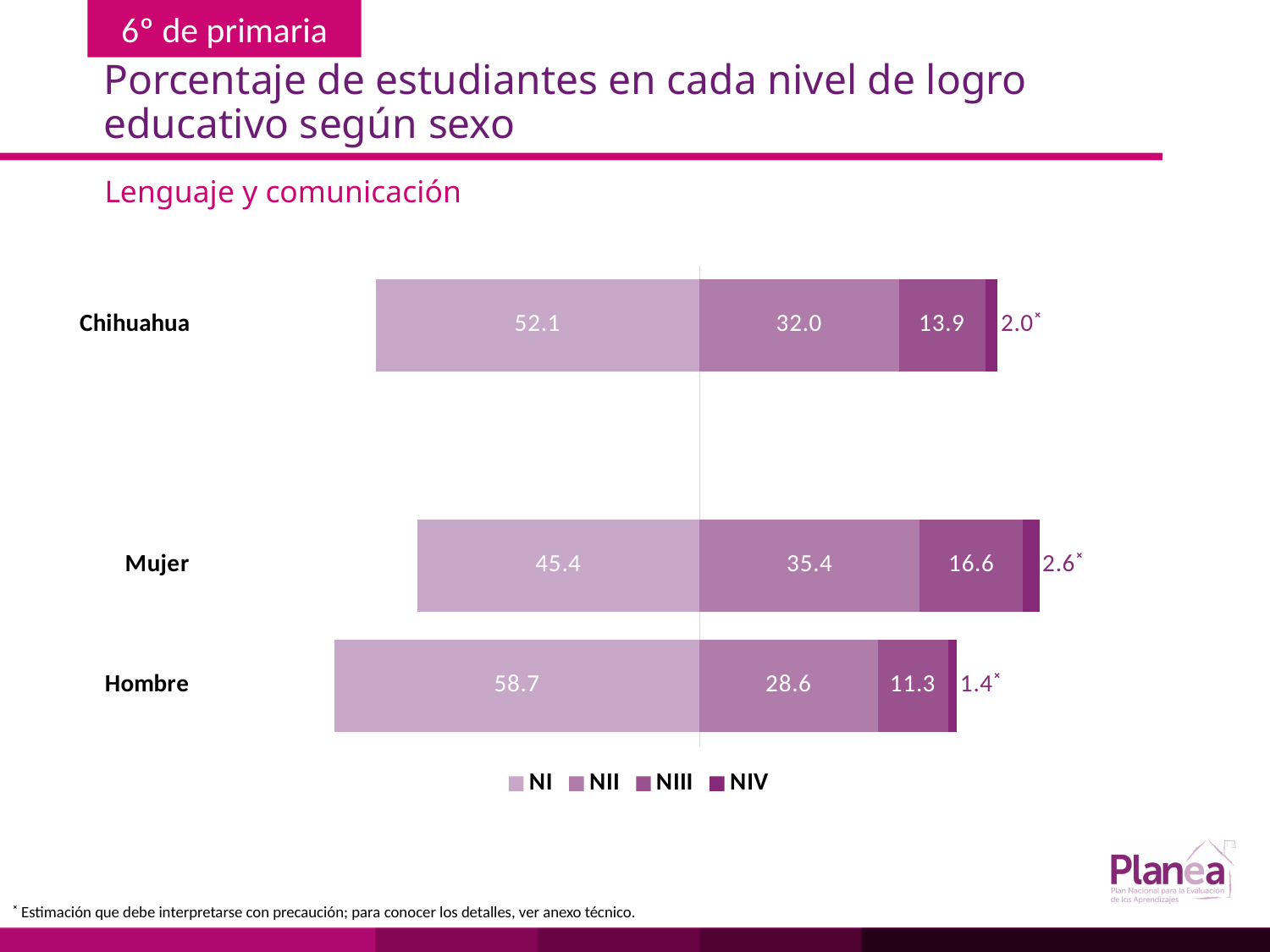
Which is larger, the NII value for Chihuahua or the NII value for Hombre? Chihuahua What is the NIV value for Hombre? 1.4 What is the NIII value for Chihuahua? 13.9 Which category has the highest NI value? Hombre How many categories are shown on the chart? 3 Which category has the lowest NIII value? Hombre What kind of chart is shown on the slide? Stacked bar chart What is the NI value for Hombre? 58.7 How many series does the legend list? 4 What is the NII value for Mujer? 35.4 What is the total of the stacked bar for Mujer? 100.0 What is the difference between the NI values for Hombre and Mujer? 13.3